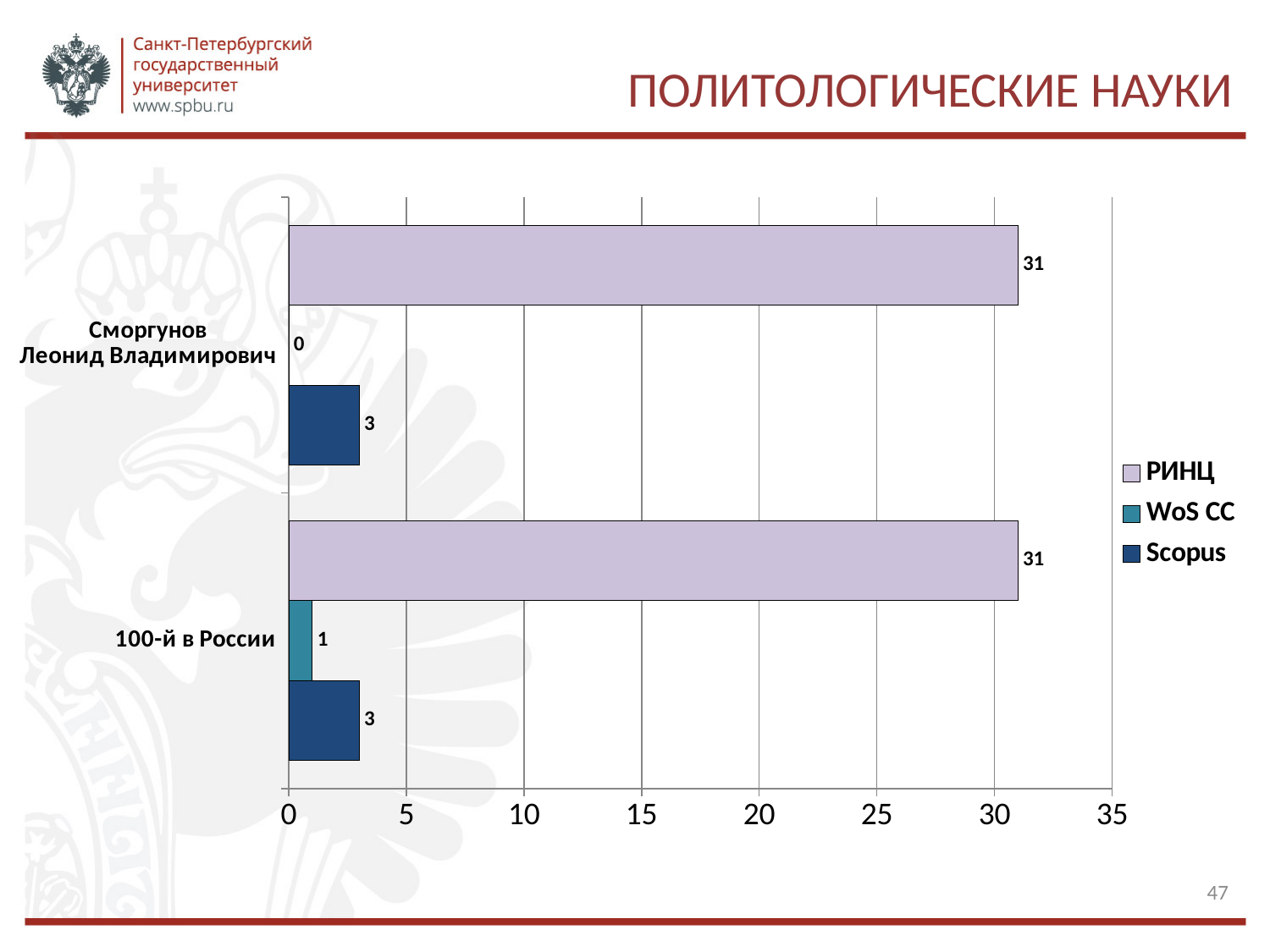
What is the WoS CC value for Сморгунов Леонид Владимирович? 0 How many series does the legend list? 3 What is the Scopus value for 100-й в России? 3 Which series has the lowest value for Сморгунов Леонид Владимирович? WoS CC Which series has the highest value for 100-й в России? РИНЦ How many categories are shown on the chart? 2 What is the title of the slide? ПОЛИТОЛОГИЧЕСКИЕ НАУКИ What kind of chart is shown on the slide? Bar chart Which is larger for 100-й в России: the WoS CC value or the Scopus value? Scopus What is the РИНЦ value for Сморгунов Леонид Владимирович? 31 What is the WoS CC value for 100-й в России? 1 What is the difference between the РИНЦ and Scopus values for Сморгунов Леонид Владимирович? 28